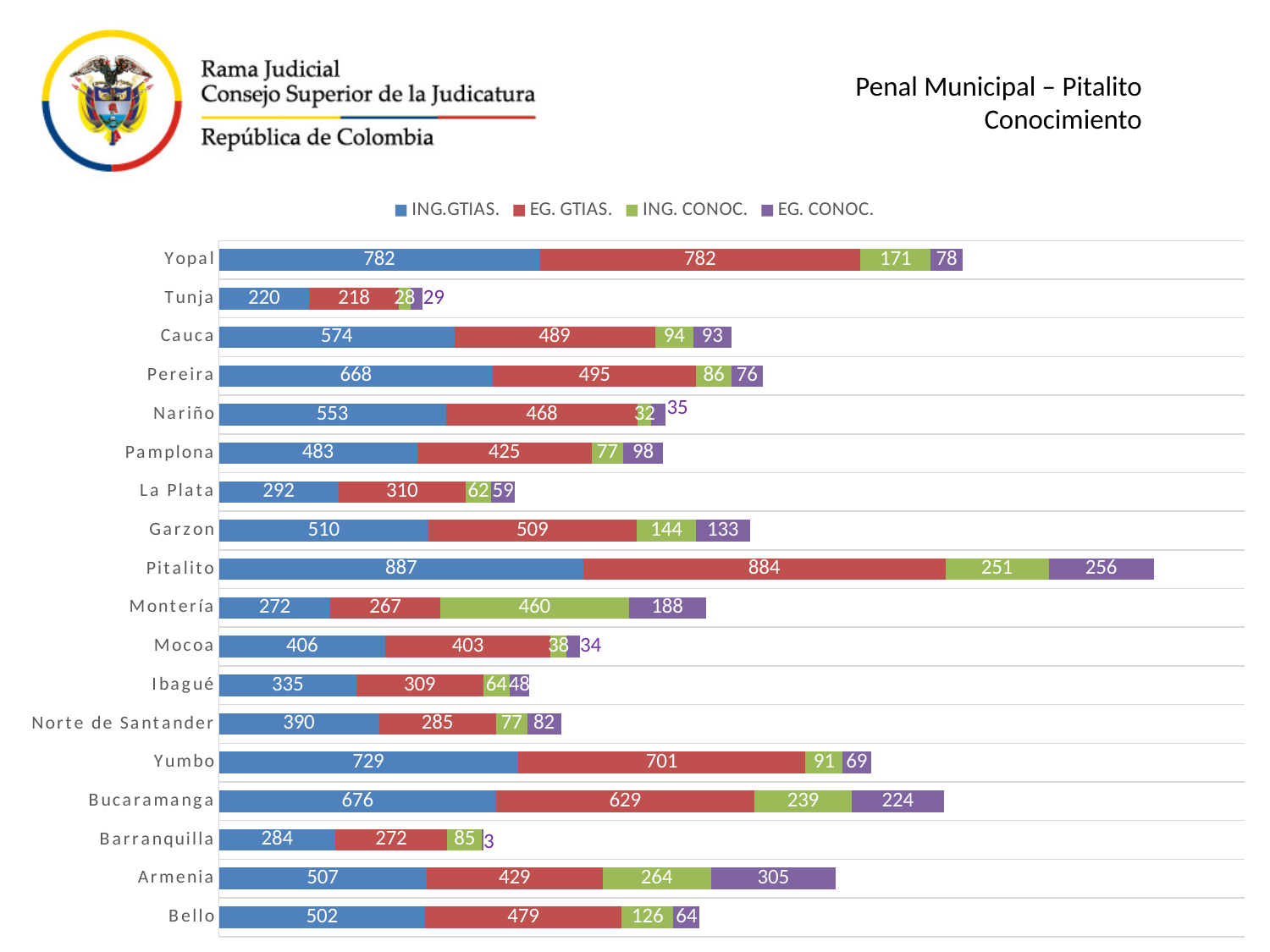
What is the difference between the ING.GTIAS. values for Pitalito and Yopal? 105 What kind of chart is shown on the slide? Stacked bar chart What is the total of the stacked bar for Tunja? 495 How many categories are shown on the chart? 18 What is the EG. CONOC. value for Barranquilla? 3 Which category has the lowest ING.GTIAS. value? Tunja Which category has the highest EG. CONOC. value? Armenia Which category has the highest ING.GTIAS. value? Pitalito Which is larger, the EG. CONOC. value for Armenia or for Pitalito? Armenia What is the ING.GTIAS. value for Pitalito? 887 What is the ING. CONOC. value for Montería? 460 How many series does the legend list? 4